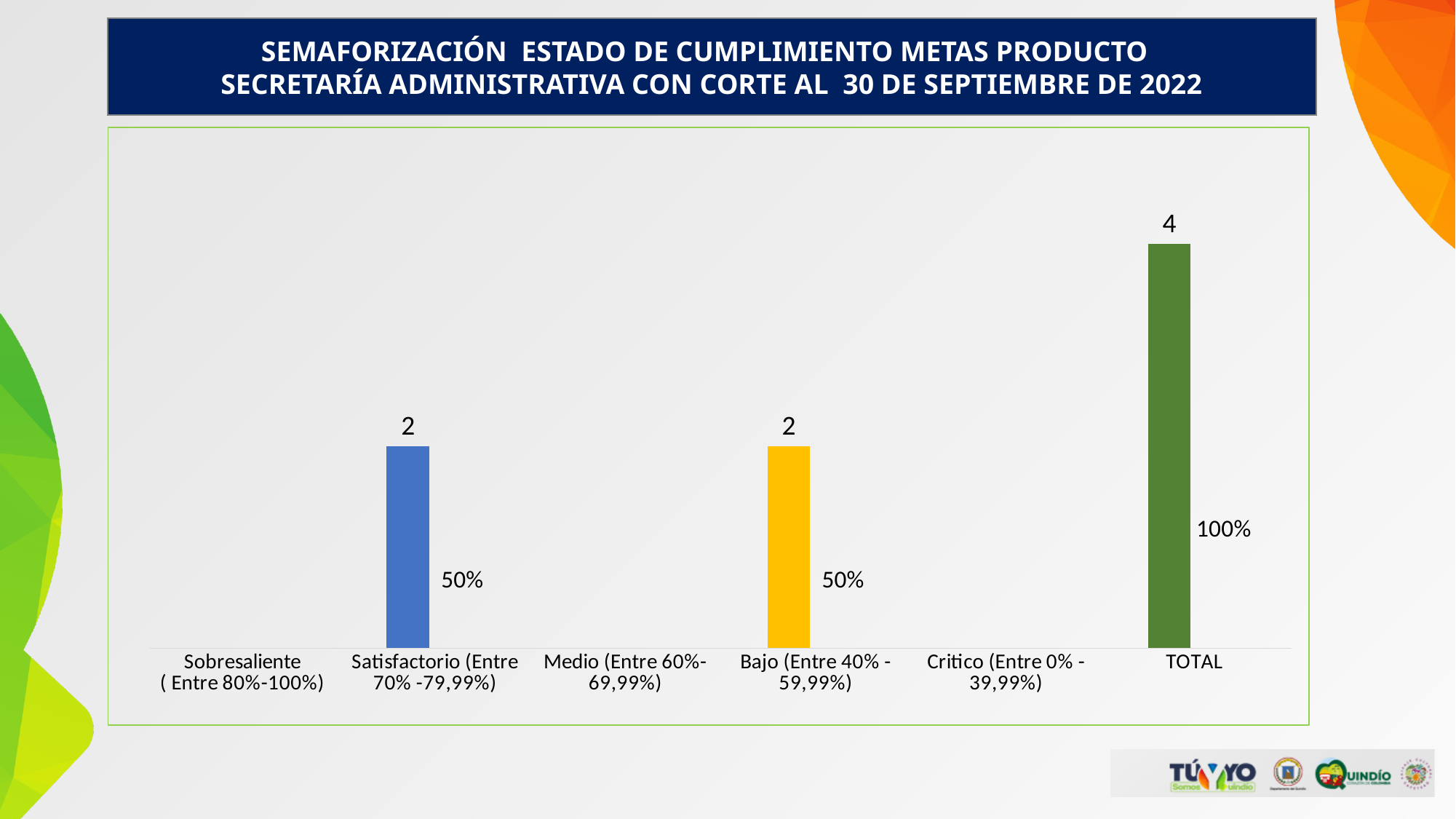
What is the cut-off date mentioned in the slide title? 30 de septiembre de 2022 Which category has the highest value? TOTAL How many categories are shown on the x axis? 6 What colour is the bar for Bajo (Entre 40% - 59,99%)? Yellow What is the value shown for Satisfactorio (Entre 70% -79,99%)? 2 Which is larger, the value for TOTAL or the value for Satisfactorio (Entre 70% -79,99%)? TOTAL What is the difference between the value for TOTAL and the value for Bajo (Entre 40% - 59,99%)? 2 What type of chart is shown on the slide? Bar chart What percentage label is shown next to the Satisfactorio (Entre 70% -79,99%) bar? 50% What is the value shown for TOTAL? 4 What is the value shown for Bajo (Entre 40% - 59,99%)? 2 What percentage label is shown next to the TOTAL bar? 100%